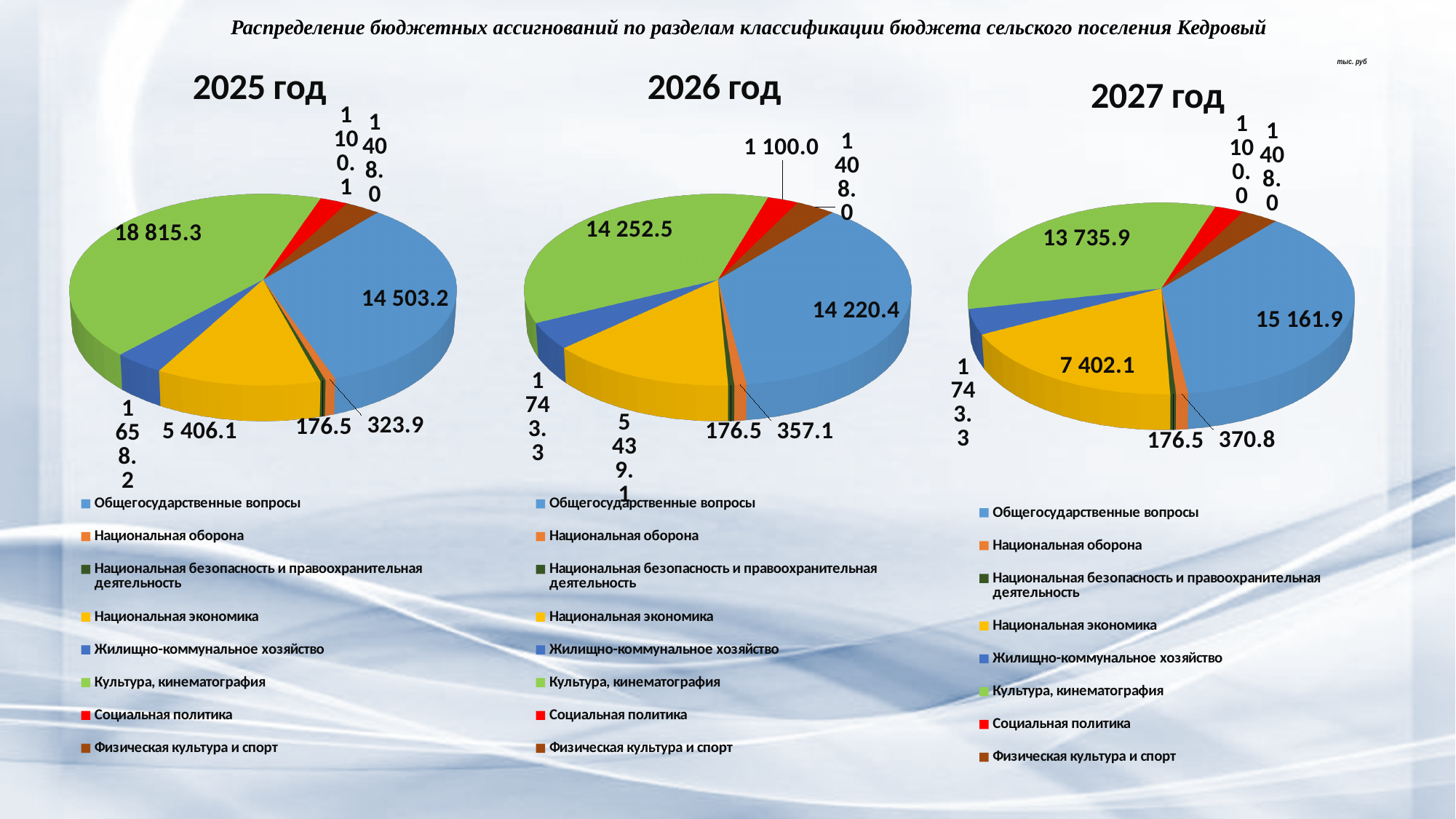
On the 2027 год chart, which category has the largest slice? Общегосударственные вопросы On the 2027 год chart, what is the difference between Общегосударственные вопросы and Культура, кинематография? 1 426.0 On the 2025 год chart, which category has the largest slice? Культура, кинематография On the 2026 год chart, what is the value for Национальная оборона? 357.1 How many categories does the legend of the 2025 год chart list? 8 What type of chart is used for the 2026 год data? Pie chart On the 2025 год chart, which category has the smallest value? Национальная безопасность и правоохранительная деятельность On the 2027 год chart, what is the value for Национальная экономика? 7 402.1 On the 2026 год chart, what is the value for Общегосударственные вопросы? 14 220.4 On the 2025 год chart, what is the difference between Национальная оборона and Национальная безопасность и правоохранительная деятельность? 147.4 On the 2025 год chart, what is the value for Культура, кинематография? 18 815.3 On the 2026 год chart, which is larger: Общегосударственные вопросы or Культура, кинематография? Культура, кинематография